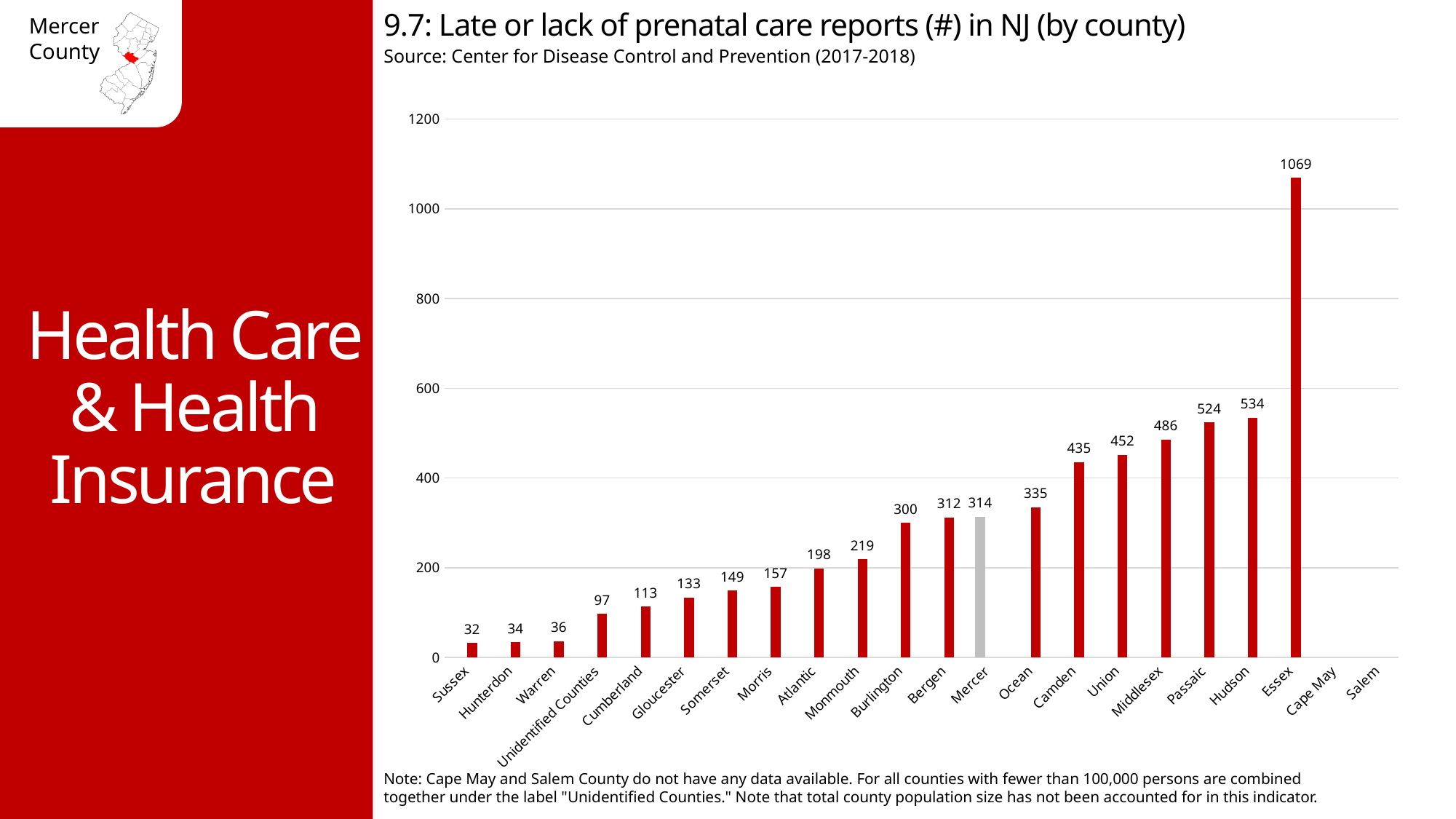
What is the difference between the values for Mercer and Bergen? 2 What is the value for Unidentified Counties? 97 Is the value for Passaic greater or less than 400? greater Which county with a plotted bar has the lowest value? Sussex Which is larger, the value for Camden or the value for Ocean? Camden What is the value for Mercer? 314 How many county labels are shown on the x axis? 22 What is the value for Essex? 1069 Which county has the highest number of late or lack of prenatal care reports? Essex What kind of chart is this? bar chart Which bar is coloured grey instead of red? Mercer What is the difference between the values for Essex and Hudson? 535